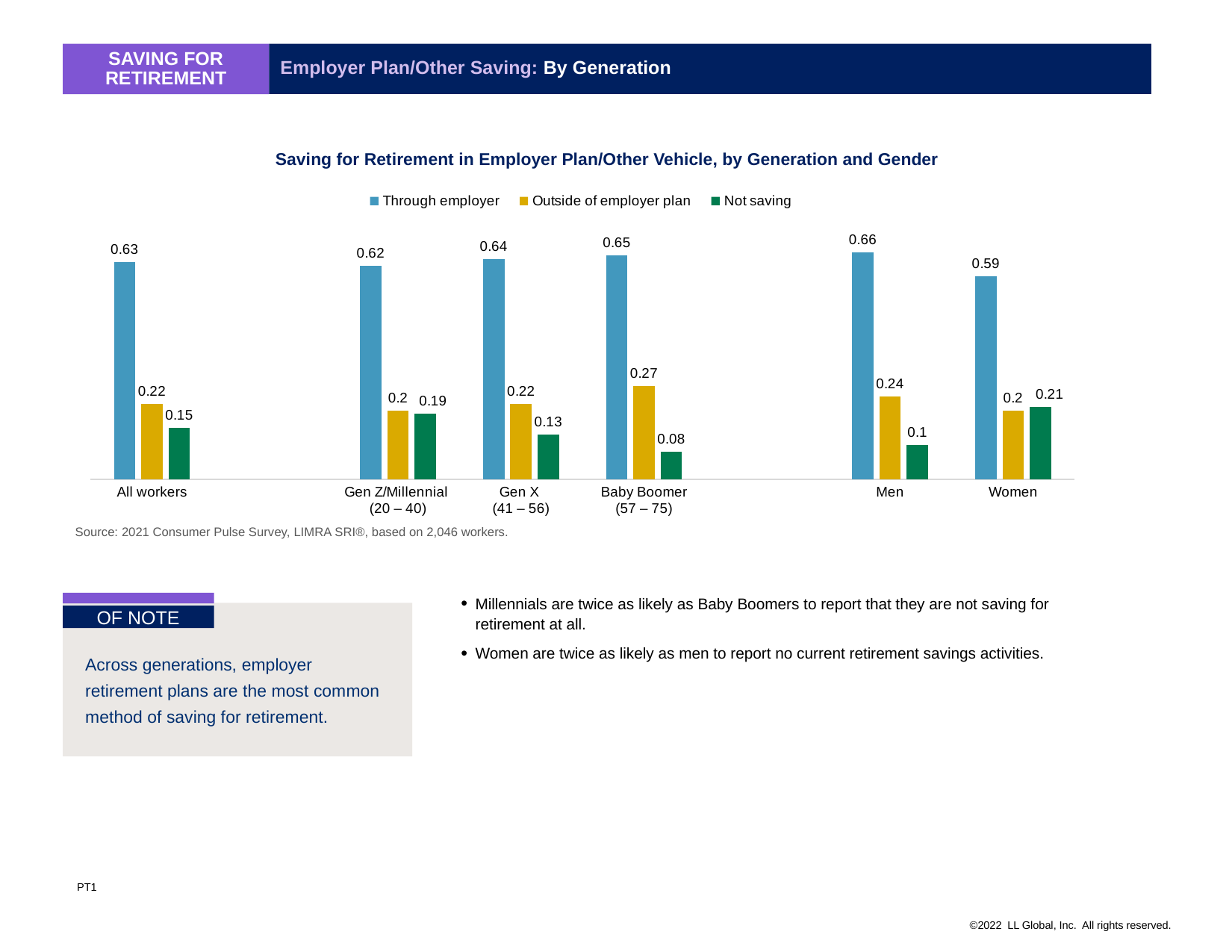
How many categories are shown on the x axis? 6 What is the title of the chart? Saving for Retirement in Employer Plan/Other Vehicle, by Generation and Gender Which category has the lowest 'Not saving' value? Baby Boomer (57 – 75) What is the 'Through employer' value for Baby Boomer (57 – 75)? 0.65 How many series does the legend list? 3 What is the difference between the 'Not saving' values for Gen Z/Millennial (20 – 40) and Baby Boomer (57 – 75)? 0.11 Which category has the highest 'Through employer' value? Men Which is larger: the 'Through employer' value for Men or for Women? Men What kind of chart is shown on the slide? Bar chart Which series is shown in green in the legend? Not saving What is the 'Not saving' value for Women? 0.21 What is the 'Outside of employer plan' value for Gen X (41 – 56)? 0.22